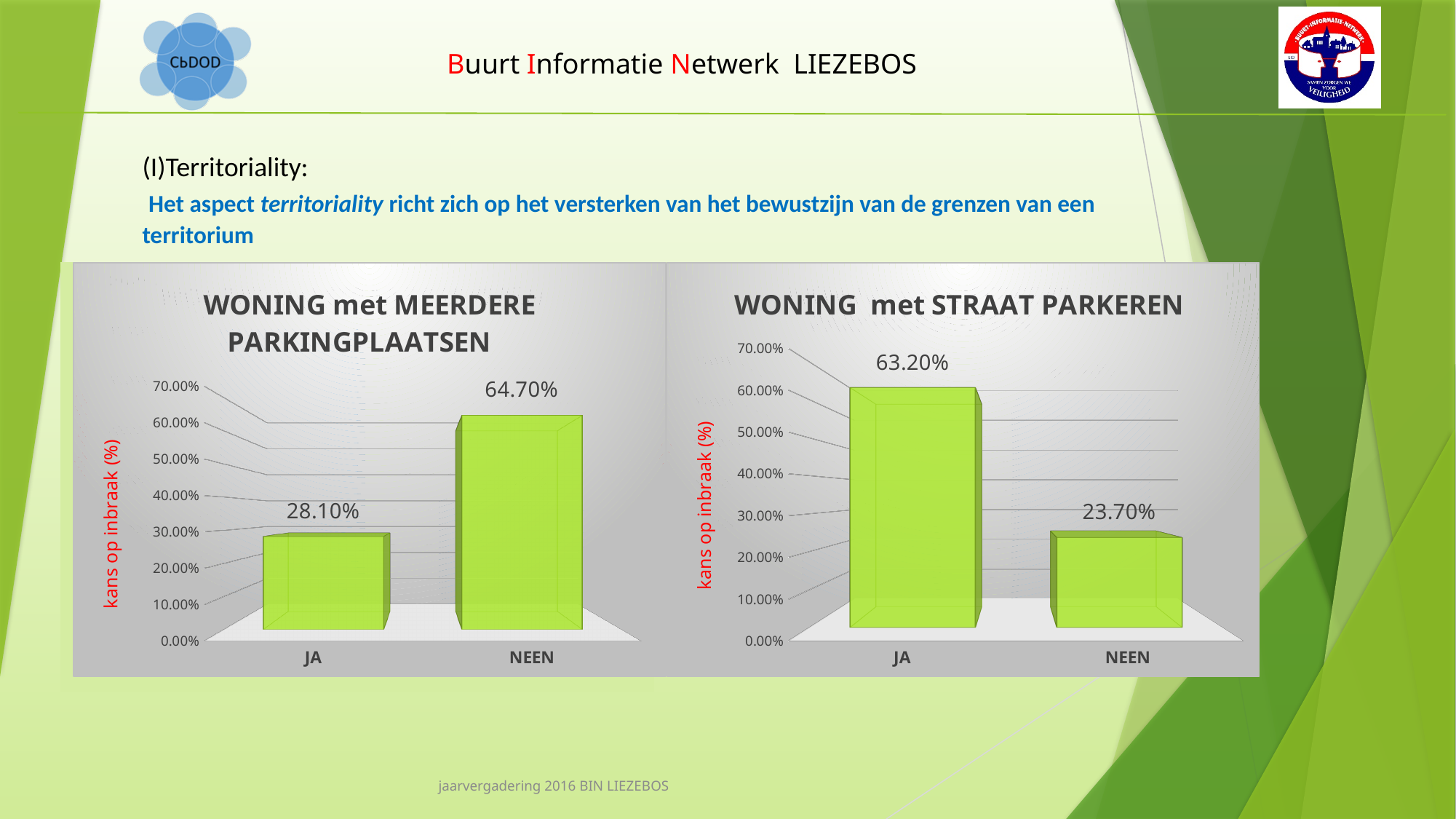
In the chart titled 'WONING met STRAAT PARKEREN', which category has the lowest value? NEEN In the chart titled 'WONING met MEERDERE PARKINGPLAATSEN', what is the value for NEEN? 64.70% How many categories are shown in the chart titled 'WONING met MEERDERE PARKINGPLAATSEN'? 2 What is the y-axis label of the chart titled 'WONING met MEERDERE PARKINGPLAATSEN'? kans op inbraak (%) In the chart titled 'WONING met MEERDERE PARKINGPLAATSEN', what is the value for JA? 28.10% What kind of chart is the chart titled 'WONING met STRAAT PARKEREN'? Bar chart In the chart titled 'WONING met STRAAT PARKEREN', what is the value for NEEN? 23.70% In the chart titled 'WONING met STRAAT PARKEREN', which is larger, the value for JA or the value for NEEN? JA In the chart titled 'WONING met STRAAT PARKEREN', what is the difference between the values for JA and NEEN? 39.50% In the chart titled 'WONING met MEERDERE PARKINGPLAATSEN', which category has the highest value? NEEN In the chart titled 'WONING met MEERDERE PARKINGPLAATSEN', what is the difference between the values for NEEN and JA? 36.60% In the chart titled 'WONING met STRAAT PARKEREN', what is the value for JA? 63.20%